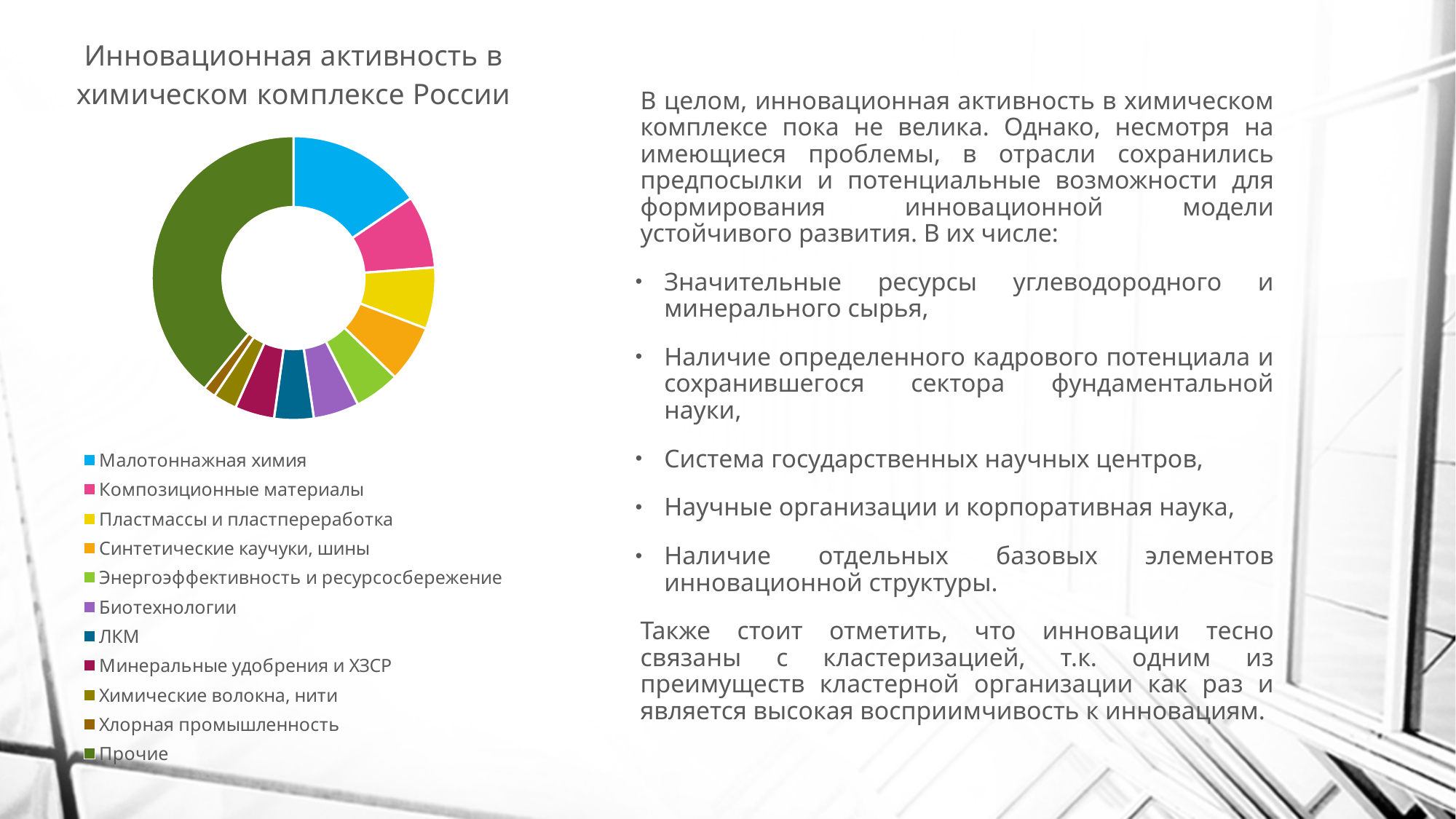
Which slice is larger: Прочие or Малотоннажная химия? Прочие What kind of chart is shown on the slide? doughnut chart What is the title of the chart? Инновационная активность в химическом комплексе России How many categories does the chart's legend list? 11 Which slice is larger: Синтетические каучуки, шины or Хлорная промышленность? Синтетические каучуки, шины Which category is shown in light blue in the chart? Малотоннажная химия Which slice is larger: Пластмассы и пластпереработка or ЛКМ? Пластмассы и пластпереработка Which category has the largest slice in the chart? Прочие Which category has the smallest slice in the chart? Хлорная промышленность